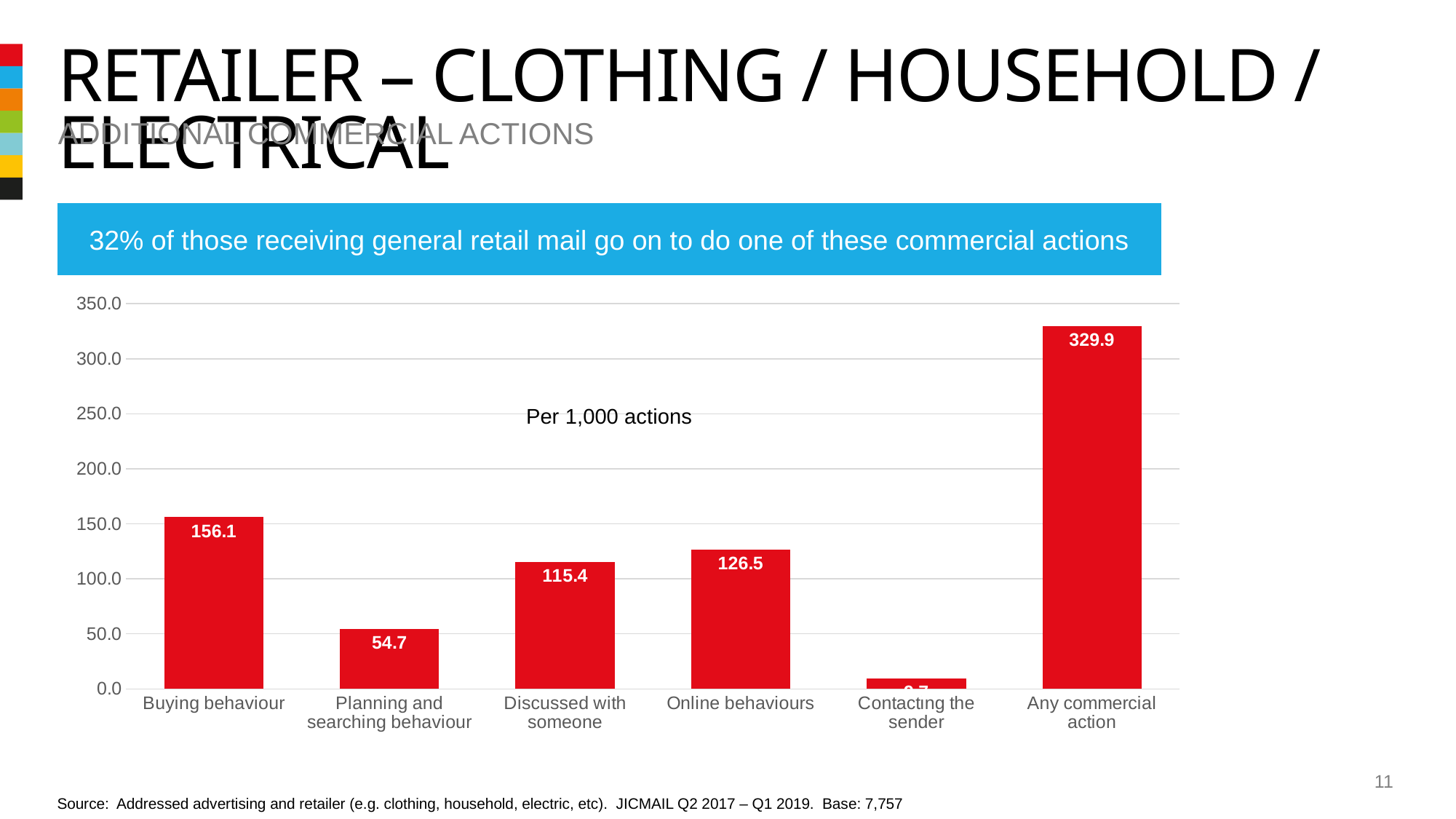
What is the value for Buying behaviour? 156.1 Which category has the highest value? Any commercial action What is the value for Discussed with someone? 115.4 How many categories are shown on the x axis? 6 Which is larger, Online behaviours or Discussed with someone? Online behaviours Which category has the lowest value? Contacting the sender What is the value for Planning and searching behaviour? 54.7 What is the value for Online behaviours? 126.5 What kind of chart is shown on the slide? Bar chart What is the difference between Buying behaviour and Planning and searching behaviour? 101.4 Is the value for Contacting the sender greater or less than 50? less What is the value for Any commercial action? 329.9